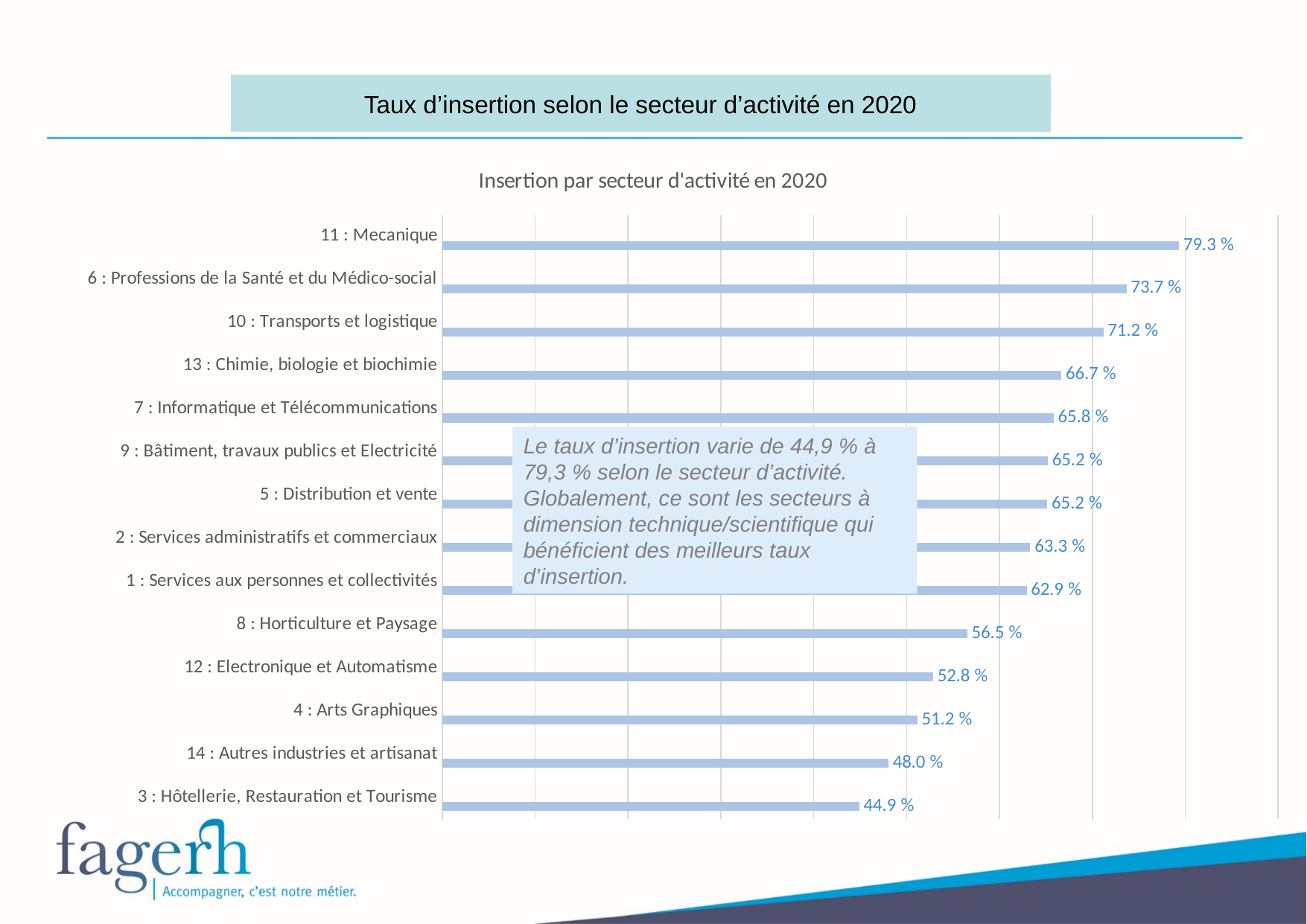
Which sector has the highest insertion rate? 11 : Mecanique Which sector has the lowest insertion rate? 3 : Hôtellerie, Restauration et Tourisme What is the insertion rate for "3 : Hôtellerie, Restauration et Tourisme"? 44.9 % What is the title of the chart? Insertion par secteur d'activité en 2020 What is the insertion rate for "11 : Mecanique"? 79.3 % What is the difference between the insertion rates of "8 : Horticulture et Paysage" and "12 : Electronique et Automatisme"? 3.7 % How many sectors are shown in the chart? 14 Which has a higher insertion rate, "10 : Transports et logistique" or "4 : Arts Graphiques"? 10 : Transports et logistique What is the insertion rate for "8 : Horticulture et Paysage"? 56.5 % What is the insertion rate for "13 : Chimie, biologie et biochimie"? 66.7 % What type of chart is shown on the slide? Bar chart What is the difference between the insertion rates of "11 : Mecanique" and "3 : Hôtellerie, Restauration et Tourisme"? 34.4 %